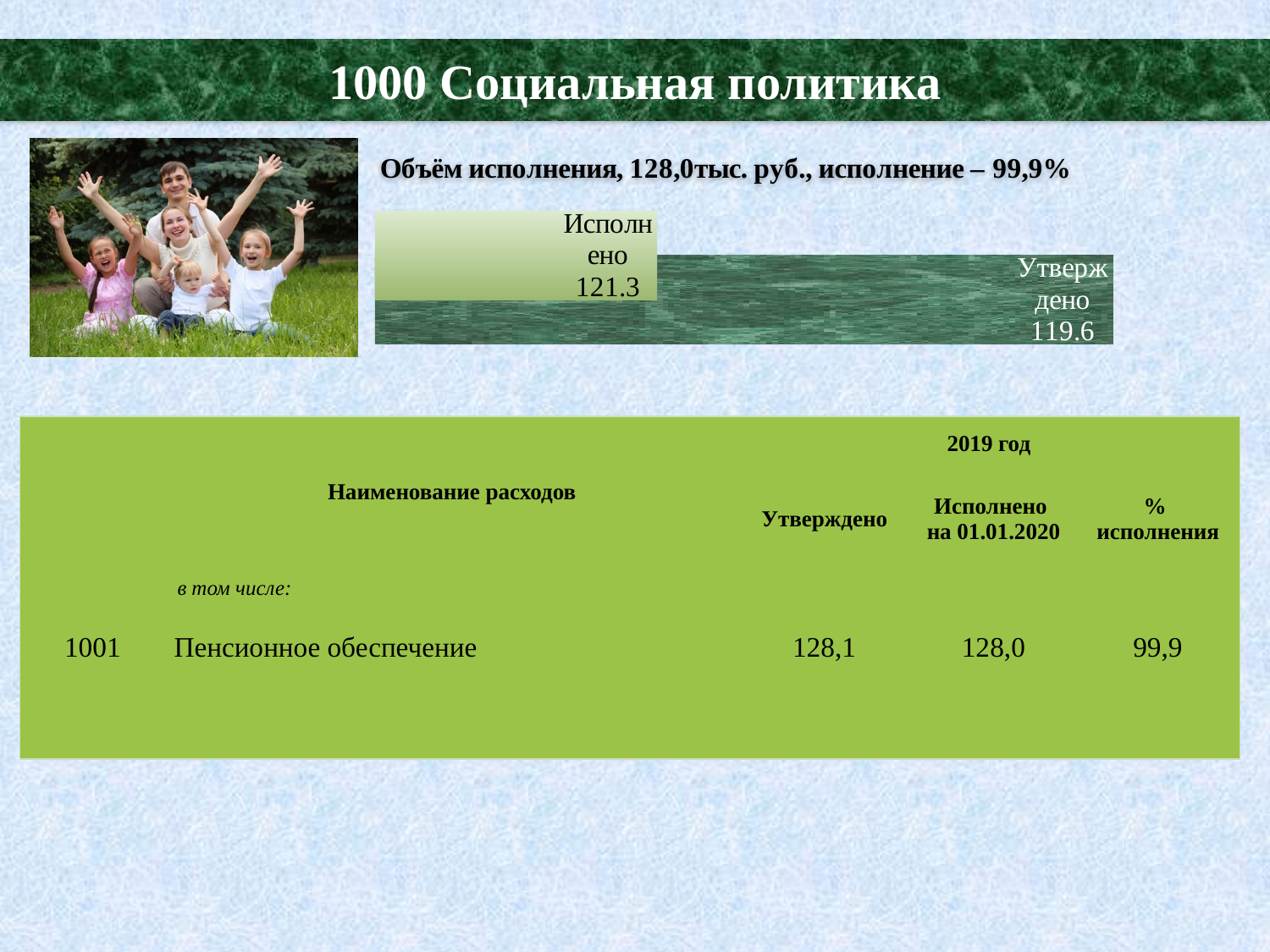
What is the difference between the labelled values for Исполнено and Утверждено in the bar chart? 1.7 Which category in the bar chart has the highest labelled value? Исполнено Which category in the bar chart has the lowest labelled value? Утверждено What value is shown for Утверждено in the bar chart? 119.6 How many bars are shown in the chart? 2 What are the two category labels shown on the bars of the chart? Исполнено and Утверждено What kind of chart is shown on the slide? bar chart What value is shown for Исполнено in the bar chart? 121.3 Which category in the bar chart has the higher labelled value, Исполнено or Утверждено? Исполнено